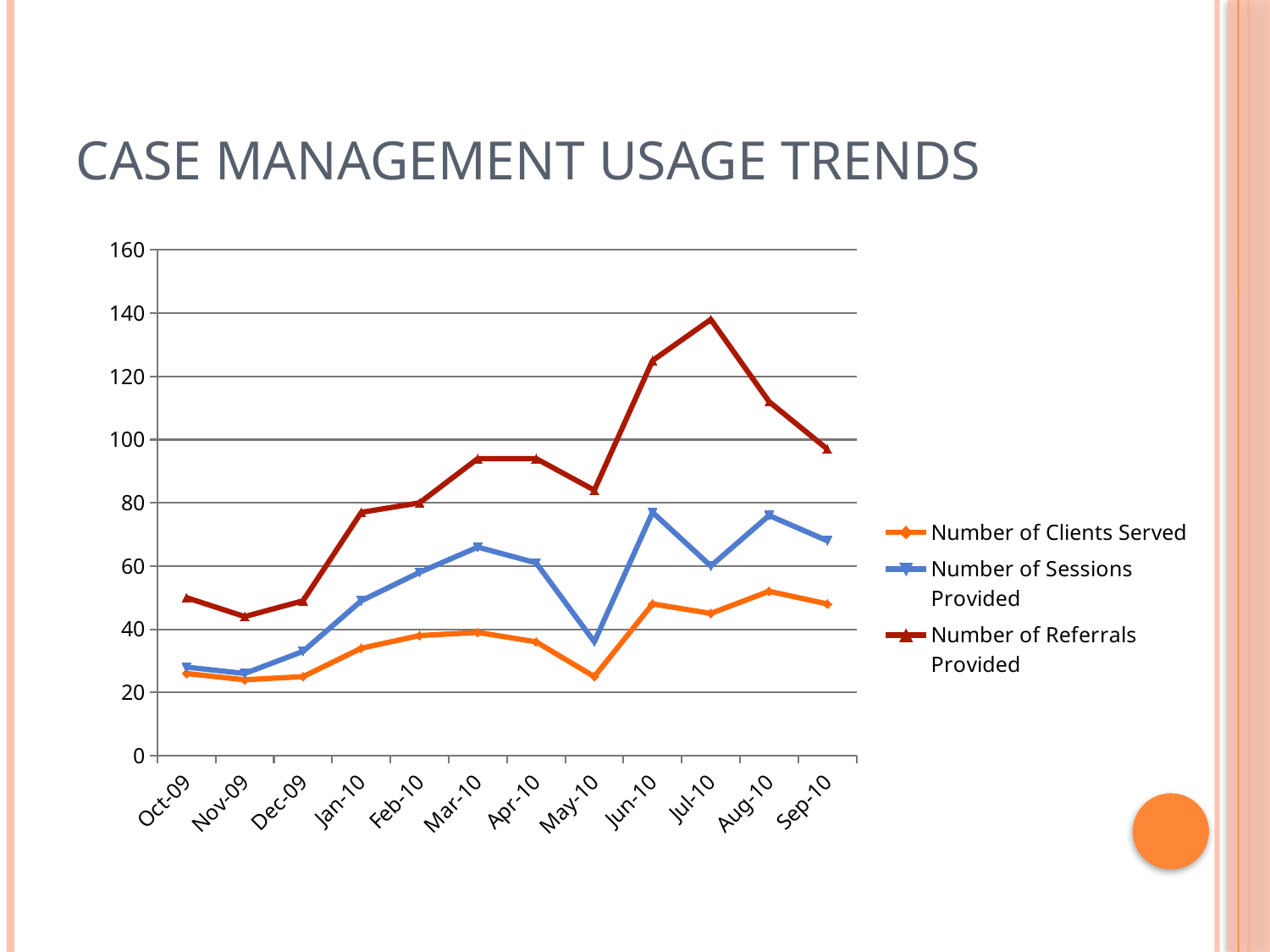
How many months are plotted along the x axis? 12 Is the value for Number of Clients Served in Jun-10 greater or less than 40? greater In which month is the Number of Referrals Provided lowest? Nov-09 How many series does the legend list? 3 Is the value for Number of Sessions Provided in May-10 greater or less than 40? less Which is larger in Jan-10: Number of Sessions Provided or Number of Clients Served? Number of Sessions Provided Is the value for Number of Referrals Provided in Oct-09 greater or less than 60? less What is the title of the chart? Case Management Usage Trends In which month is the Number of Referrals Provided highest? Jul-10 What kind of chart is shown on the slide? Line chart Does the Number of Referrals Provided rise or fall from Jul-10 to Sep-10? fall